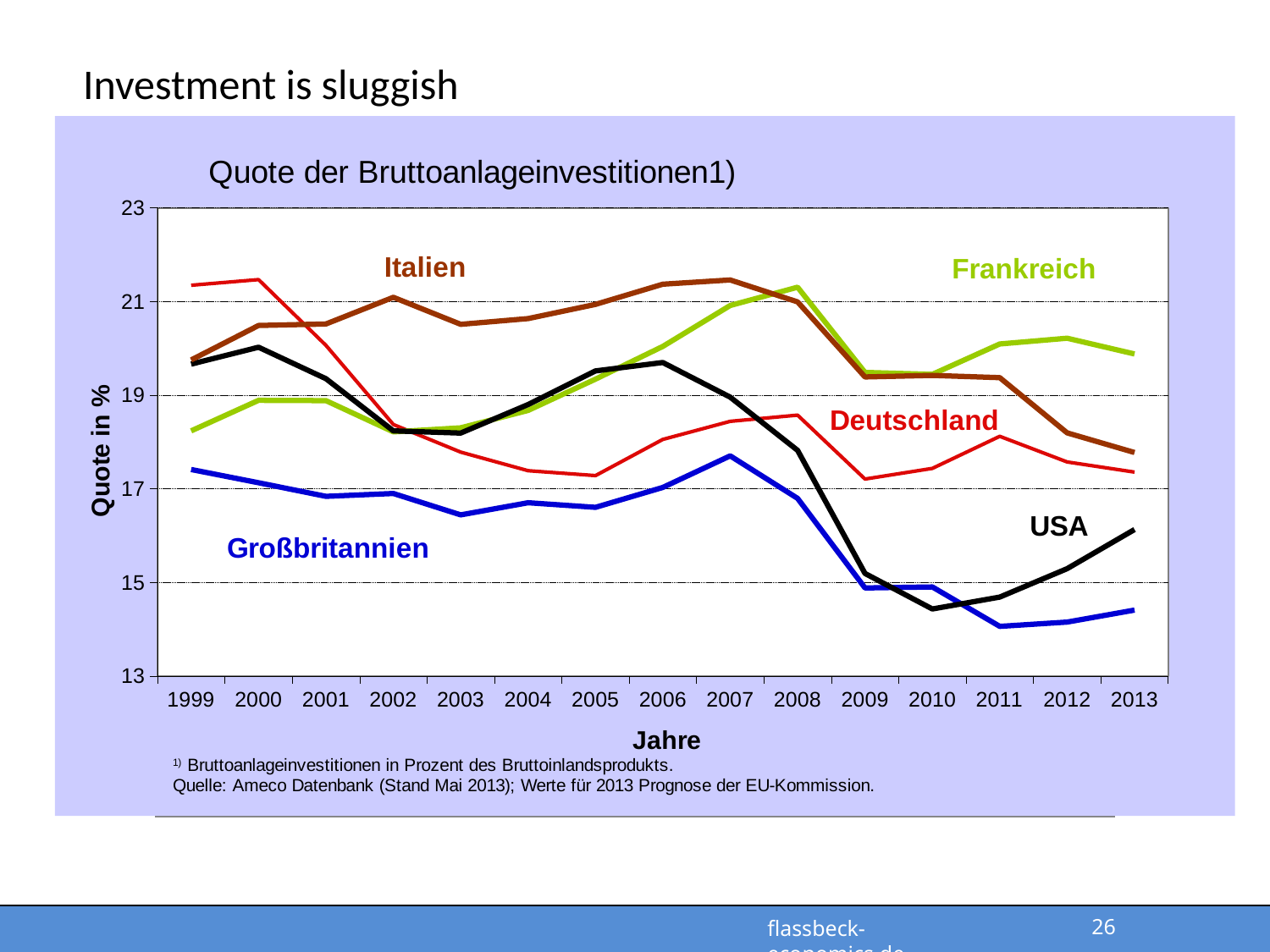
What kind of chart is shown on the slide? line chart How many series (countries) are plotted in the chart? 5 What is the label of the y axis? Quote in % Which is larger in 2000, the value for Deutschland or the value for USA? Deutschland Is the value for Italien in 2007 greater or less than 21? greater Is the value for USA in 2010 greater or less than 15? less Which series has the lowest value in 2013? Großbritannien Does the value for USA rise or fall from 2007 to 2010? fall Which series has the highest value in 2013? Frankreich How many years are shown along the x axis? 15 Is the value for Großbritannien in 2011 greater or less than 15? less Which is larger in 2009, the value for USA or the value for Deutschland? Deutschland